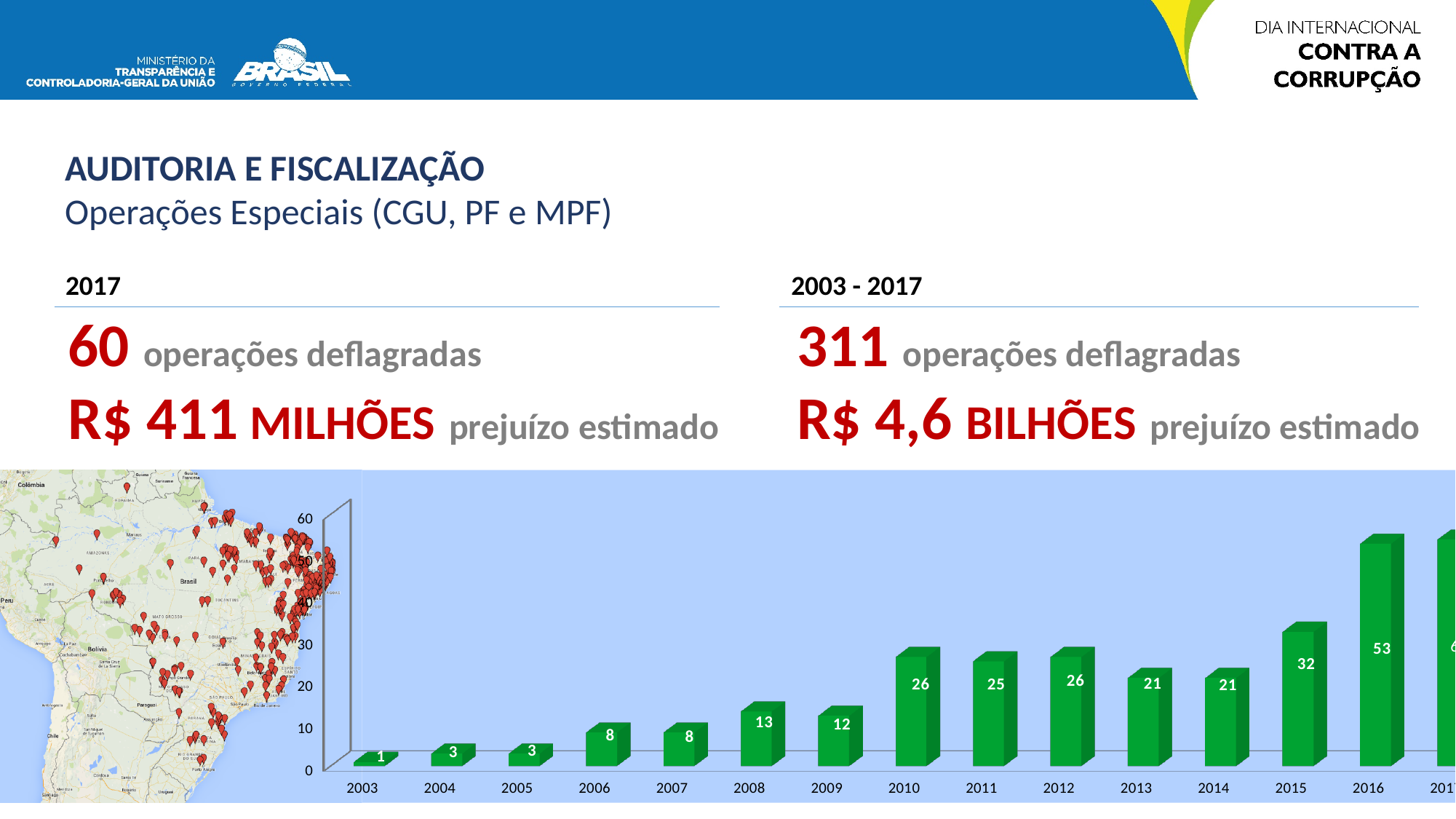
What is the difference between the values for 2016 and 2015 in the bar chart? 21 What colour are the bars in the bar chart? green Is the value for 2012 in the bar chart greater or less than 20? greater What is the value for 2008 in the bar chart? 13 Do the values in the bar chart generally rise or fall from 2003 to 2016? rise What kind of chart is shown at the bottom of the slide? bar chart What is the value for 2016 in the bar chart? 53 How many years are shown on the x axis of the bar chart? 15 What is the value for 2010 in the bar chart? 26 Which is larger in the bar chart, the value for 2009 or the value for 2010? 2010 Which year has the lowest value in the bar chart? 2003 What is the value for 2015 in the bar chart? 32